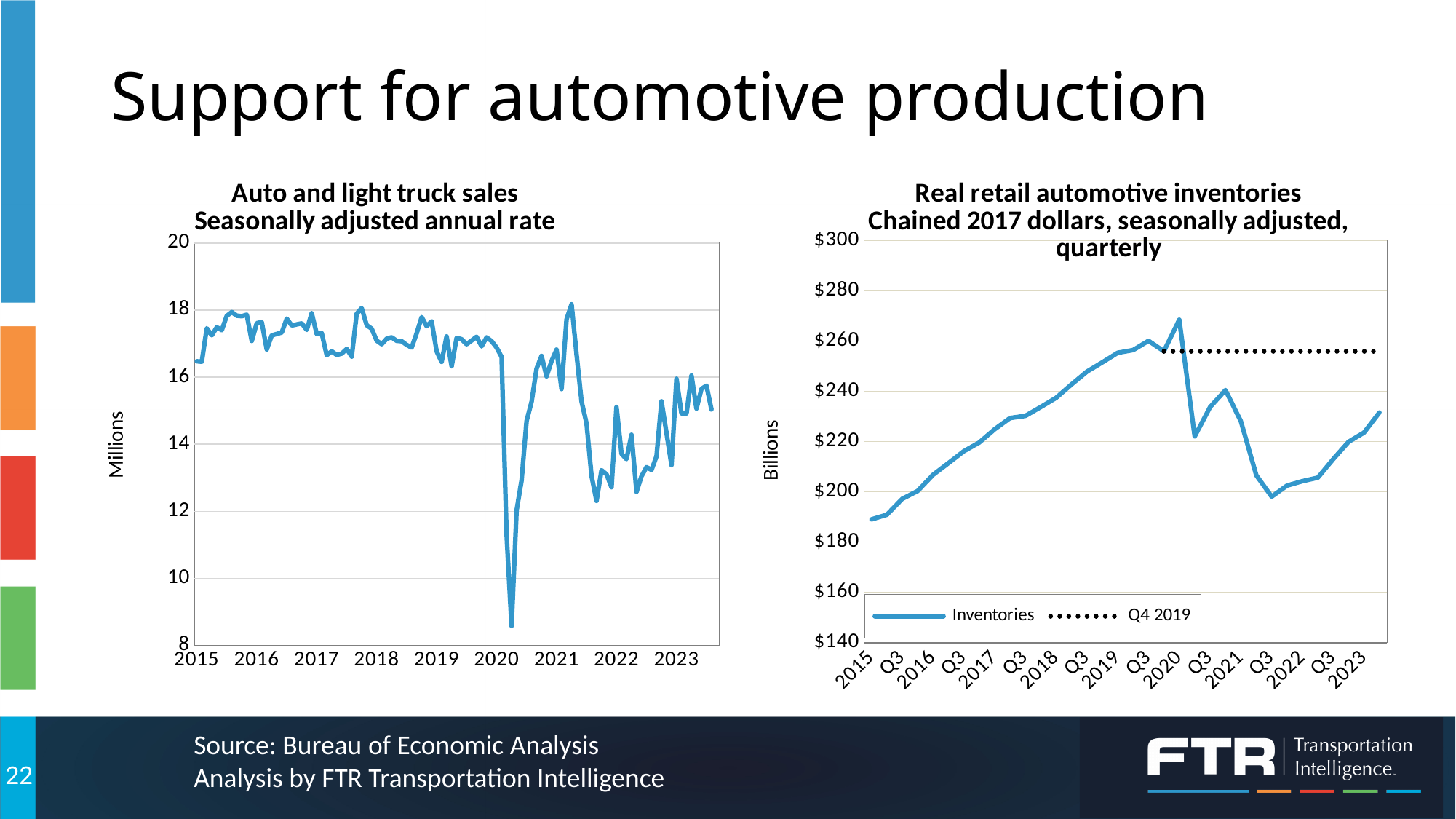
In the 'Real retail automotive inventories' chart, how many series does the legend list? 2 What is the y-axis label of the 'Auto and light truck sales' chart? Millions In the 'Auto and light truck sales' chart, is the value at the start of 2022 greater or less than 14? greater In the 'Real retail automotive inventories' chart, do Inventories rise or fall from 2015 to 2019? rise In the 'Real retail automotive inventories' chart, what are the two entries in the legend? Inventories and Q4 2019 In the 'Real retail automotive inventories' chart, is the Q4 2019 dotted reference line greater or less than $240? greater In the 'Real retail automotive inventories' chart, is the peak Inventories value in 2020 greater or less than $260? greater What kind of chart is the 'Real retail automotive inventories' chart on the right? line chart What kind of chart is the 'Auto and light truck sales' chart on the left? line chart In the 'Real retail automotive inventories' chart, do Inventories rise or fall from Q3 2021 to 2023? rise